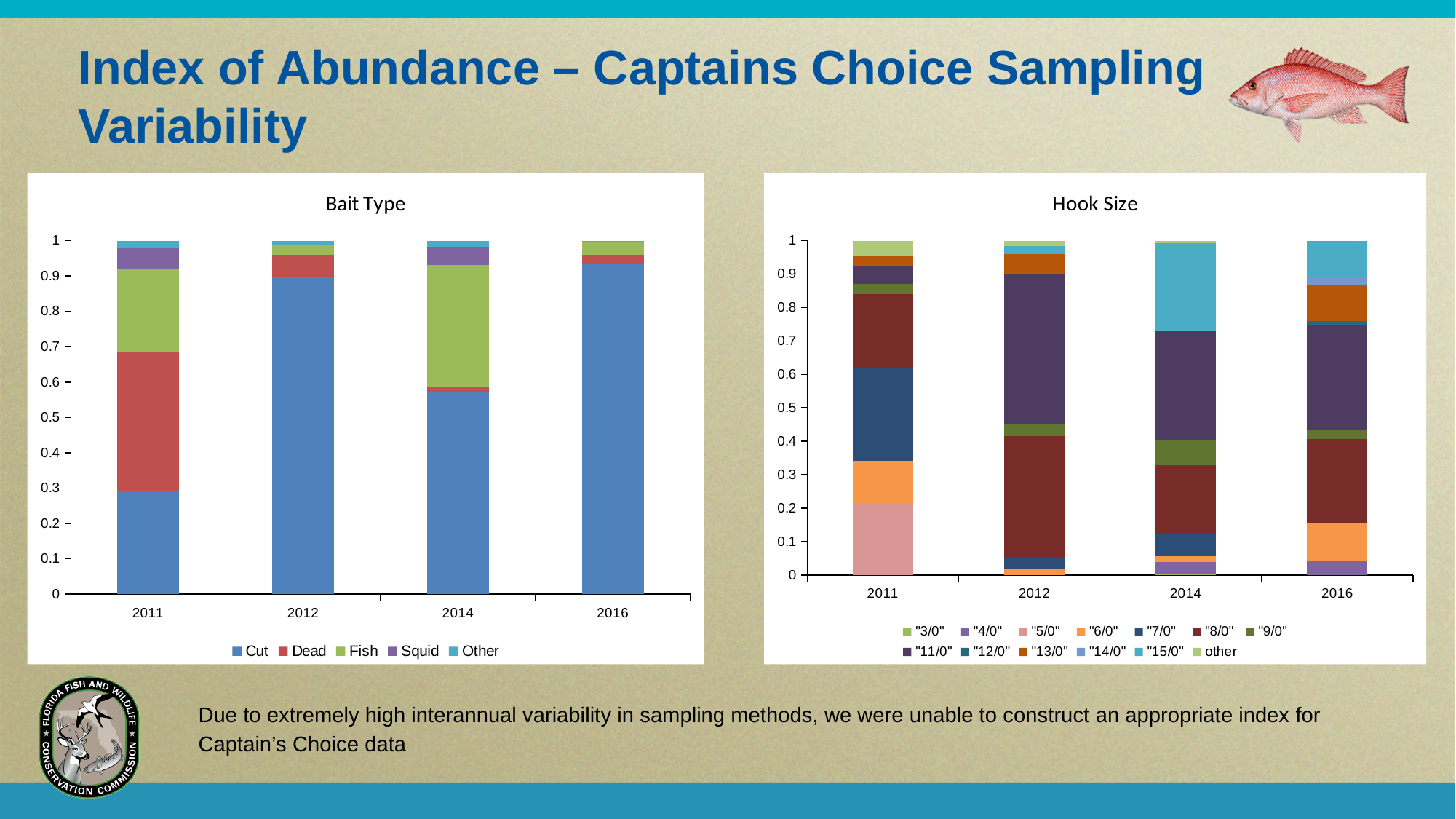
How many series does the legend of the Hook Size chart list? 13 In the Hook Size chart, is the "5/0" value for 2011 greater or less than 0.1? greater In the Bait Type chart, is the Cut value for 2012 greater or less than 0.8? greater In the Bait Type chart, which year has the largest Cut share? 2016 In the Bait Type chart, is the Cut value for 2011 greater or less than 0.4? less In the Bait Type chart, which year has the smallest Cut share? 2011 In the Bait Type chart, is the Dead share larger in 2011 or 2012? 2011 In the Hook Size chart, which year has the largest "15/0" segment? 2014 What kind of chart is the Bait Type chart? Stacked bar chart How many years are shown on the x axis of the Hook Size chart? 4 What is the total height of the 2011 stacked bar in the Bait Type chart? 1 How many series does the legend of the Bait Type chart list? 5